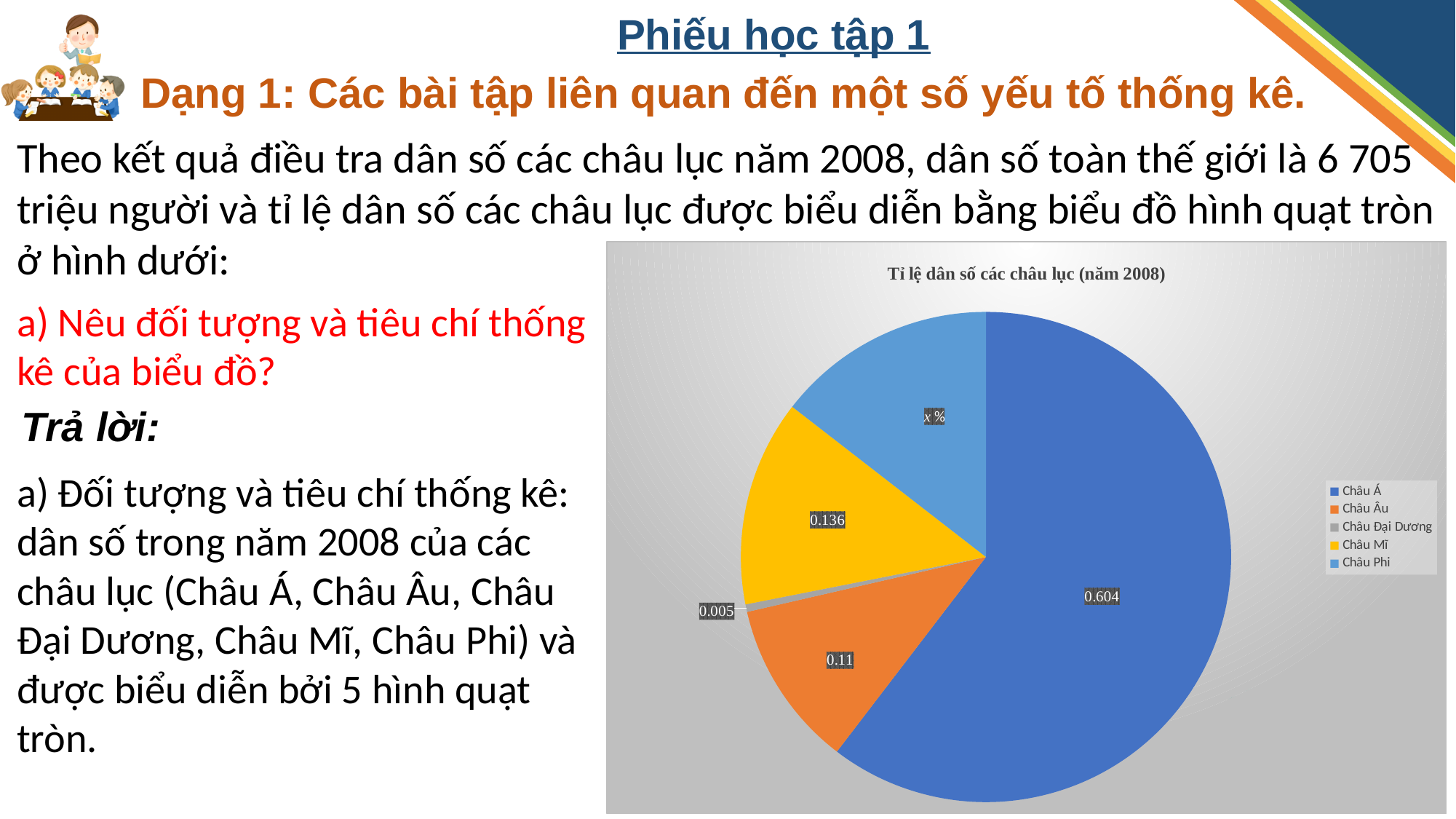
What is the difference between the labelled values for Châu Á and Châu Âu? 0.494 Which continent has the smallest slice of the pie? Châu Đại Dương What value is labelled on the Châu Á slice? 0.604 How many entries does the chart legend list? 5 What value is labelled on the Châu Âu slice? 0.11 What value is labelled on the Châu Đại Dương slice? 0.005 What type of chart is shown on the slide? Pie chart What value is labelled on the Châu Mĩ slice? 0.136 Which continent has the largest slice of the pie? Châu Á What is the title of the chart? Tỉ lệ dân số các châu lục (năm 2008) How many slices does the pie chart have? 5 Which slice is larger, Châu Mĩ or Châu Âu? Châu Mĩ